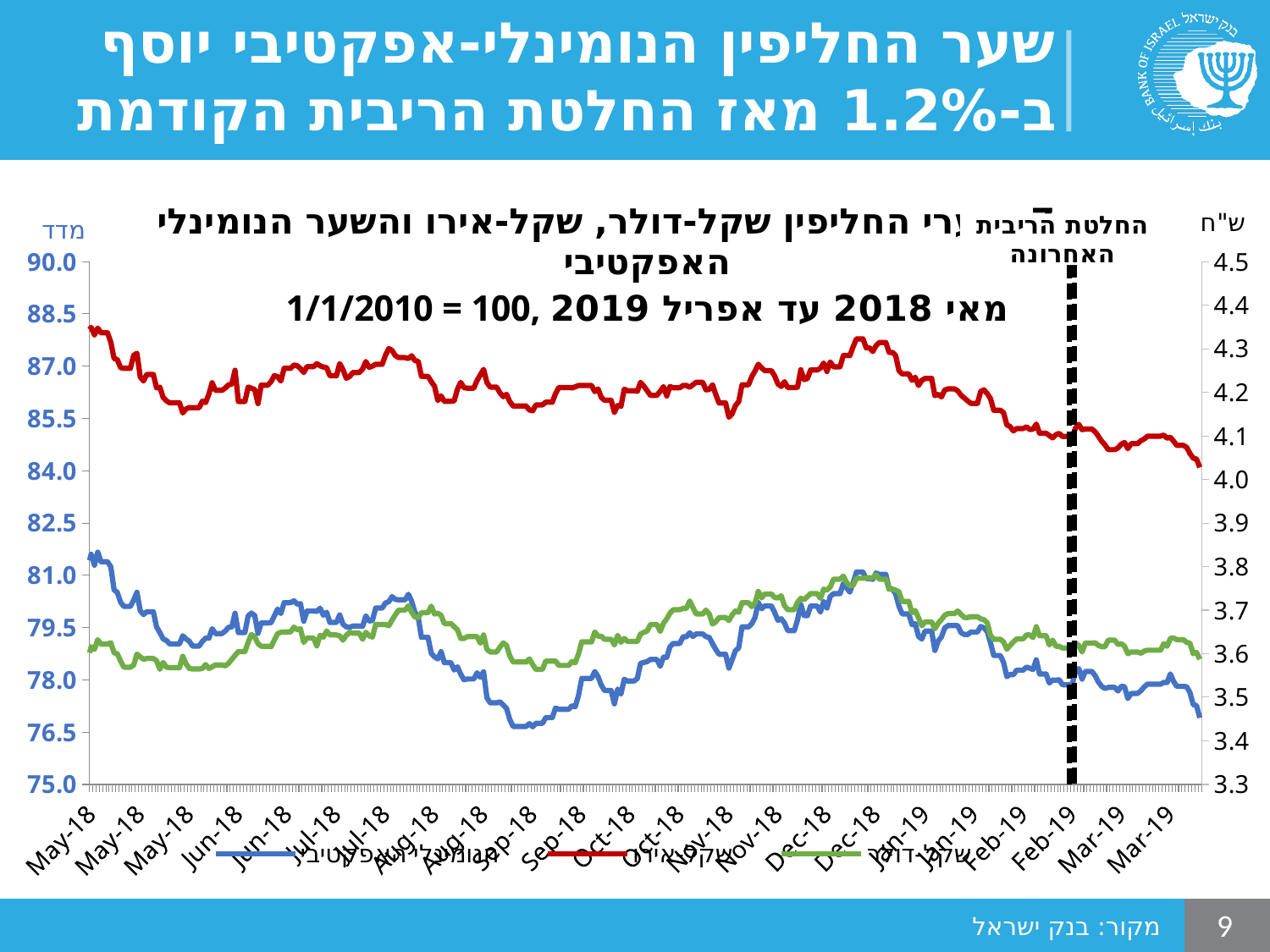
What kind of chart is shown on the slide? line chart Does the red שקל-אירו line rise or fall overall from May-18 to Mar-19? fall Is the value of the blue nominal effective exchange rate line at the end of the series (Mar-19) greater or less than 78.0 on the left axis? less How many series does the chart's legend list? 3 Is the value of the red שקל-אירו line at the start of the series (May-18) greater or less than 4.3 on the right axis? greater On the right axis, which is higher in Mar-19: the שקל-אירו line or the שקל-דולר line? שקל-אירו According to the slide title, by what percentage did the nominal effective exchange rate appreciate since the previous interest rate decision? 1.2% Is the value of the red שקל-אירו line at the end of the series (Mar-19) greater or less than 4.1 on the right axis? less What is the label of the right-hand vertical axis? ש"ח Does the blue nominal effective exchange rate line rise or fall overall from May-18 to Mar-19? fall What event does the dashed vertical line on the chart mark? החלטת הריבית האחרונה